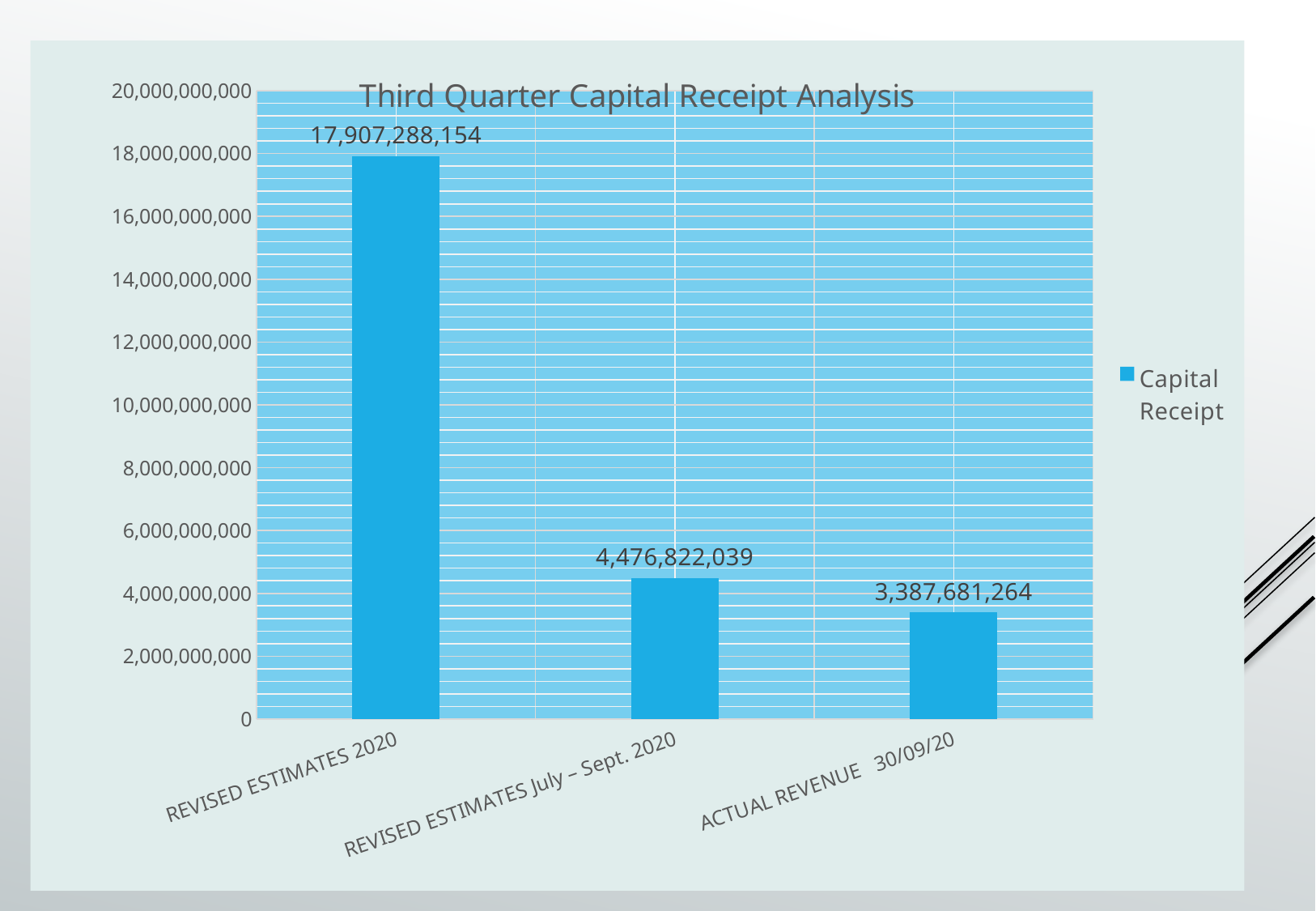
Is the value for ACTUAL REVENUE 30/09/20 greater or less than 4,000,000,000? less What is the difference between the REVISED ESTIMATES July – Sept. 2020 value and the ACTUAL REVENUE 30/09/20 value? 1,089,140,775 What is the title of the chart? Third Quarter Capital Receipt Analysis What type of chart is shown on the slide? Bar chart What is the Capital Receipt value for ACTUAL REVENUE 30/09/20? 3,387,681,264 What is the Capital Receipt value for REVISED ESTIMATES 2020? 17,907,288,154 Which is larger, the value for REVISED ESTIMATES July – Sept. 2020 or the value for ACTUAL REVENUE 30/09/20? REVISED ESTIMATES July – Sept. 2020 Which category has the lowest Capital Receipt value? ACTUAL REVENUE 30/09/20 What is the difference between the REVISED ESTIMATES 2020 value and the REVISED ESTIMATES July – Sept. 2020 value? 13,430,466,115 How many categories are shown on the x axis of the chart? 3 What is the Capital Receipt value for REVISED ESTIMATES July – Sept. 2020? 4,476,822,039 Which category has the highest Capital Receipt value? REVISED ESTIMATES 2020